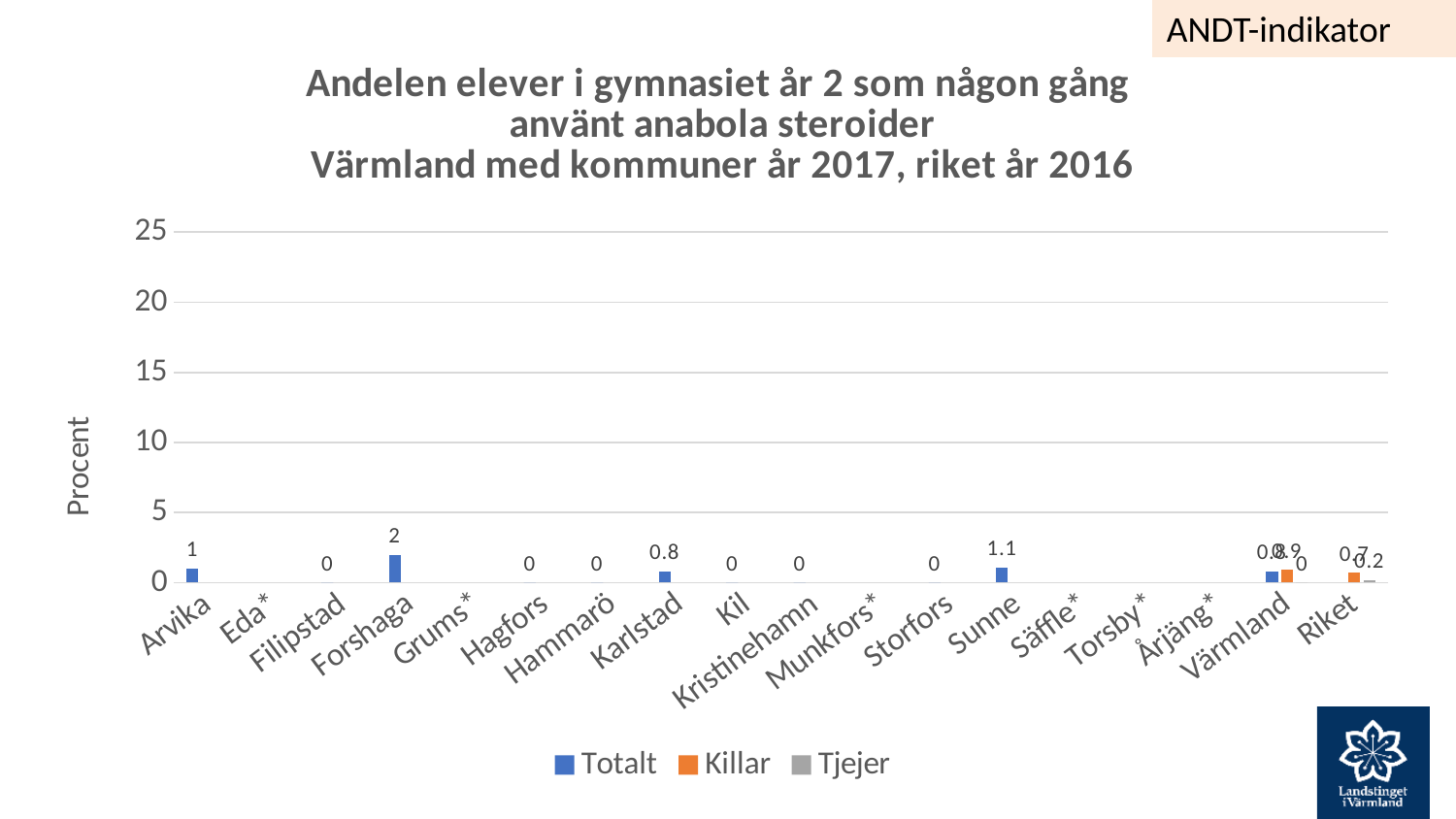
Which municipality has the highest Totalt value? Forshaga What is the Totalt value for Arvika? 1 How many categories are shown on the x axis? 18 What is the Totalt value for Forshaga? 2 What is the label on the y axis? Procent What is the Totalt value for Sunne? 1.1 What is the difference between the Totalt values for Forshaga and Sunne? 0.9 Is the Totalt value for Forshaga greater or less than 5? less Which has the larger Totalt value, Arvika or Sunne? Sunne What is the Totalt value for Karlstad? 0.8 How many series does the legend list? 3 What kind of chart is shown on the slide? Bar chart